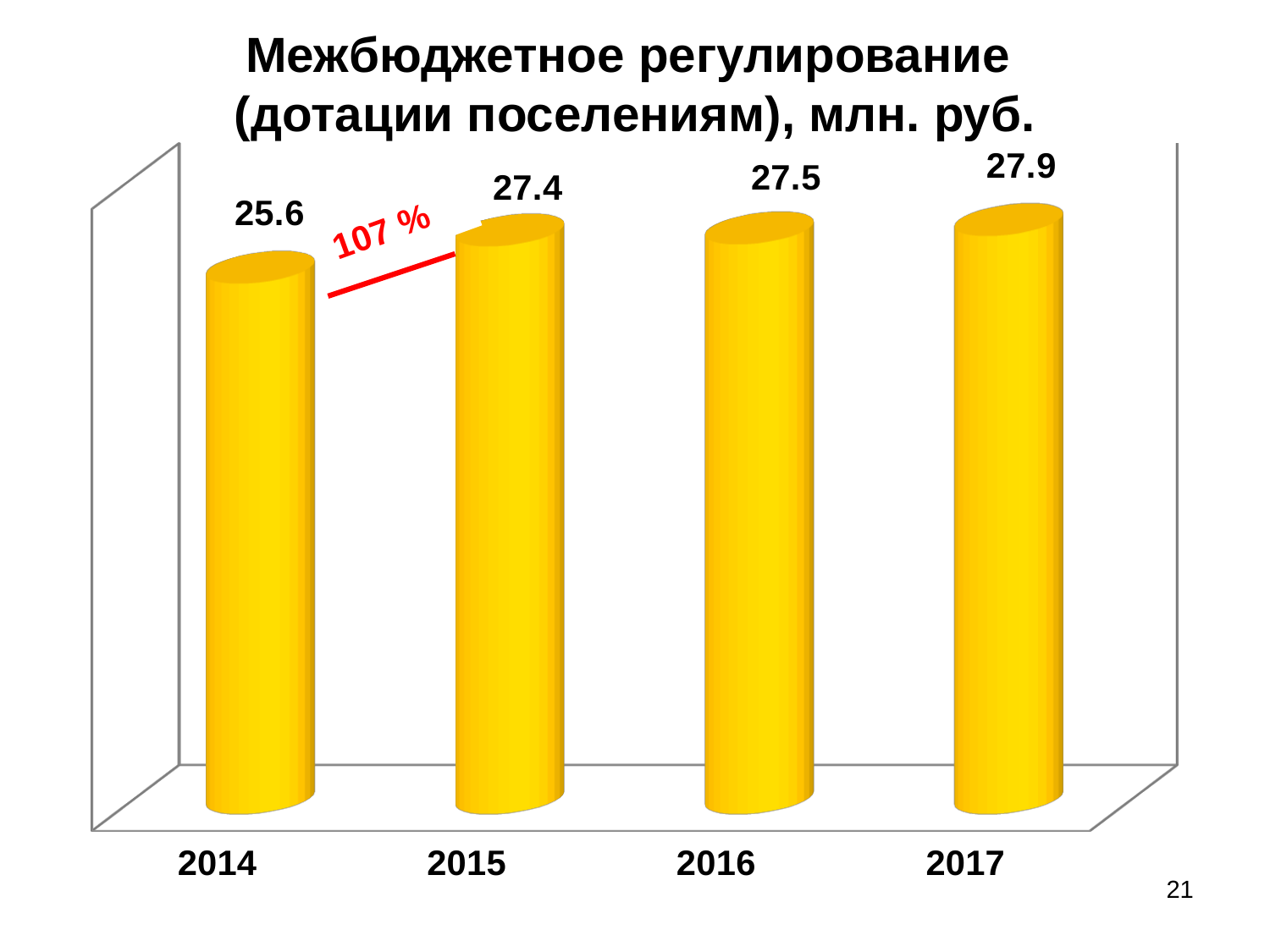
What kind of chart is this? bar chart Which year has the highest value? 2017 What is the difference between the values for 2015 and 2014? 1.8 What is the value for 2016? 27.5 What is the value for 2015? 27.4 Do the values rise or fall from 2014 to 2017? rise What is the value for 2017? 27.9 Which year has the lowest value? 2014 What is the value for 2014? 25.6 What is the difference between the values for 2017 and 2014? 2.3 Which is larger, the value for 2014 or the value for 2015? 2015 How many years are shown on the chart? 4